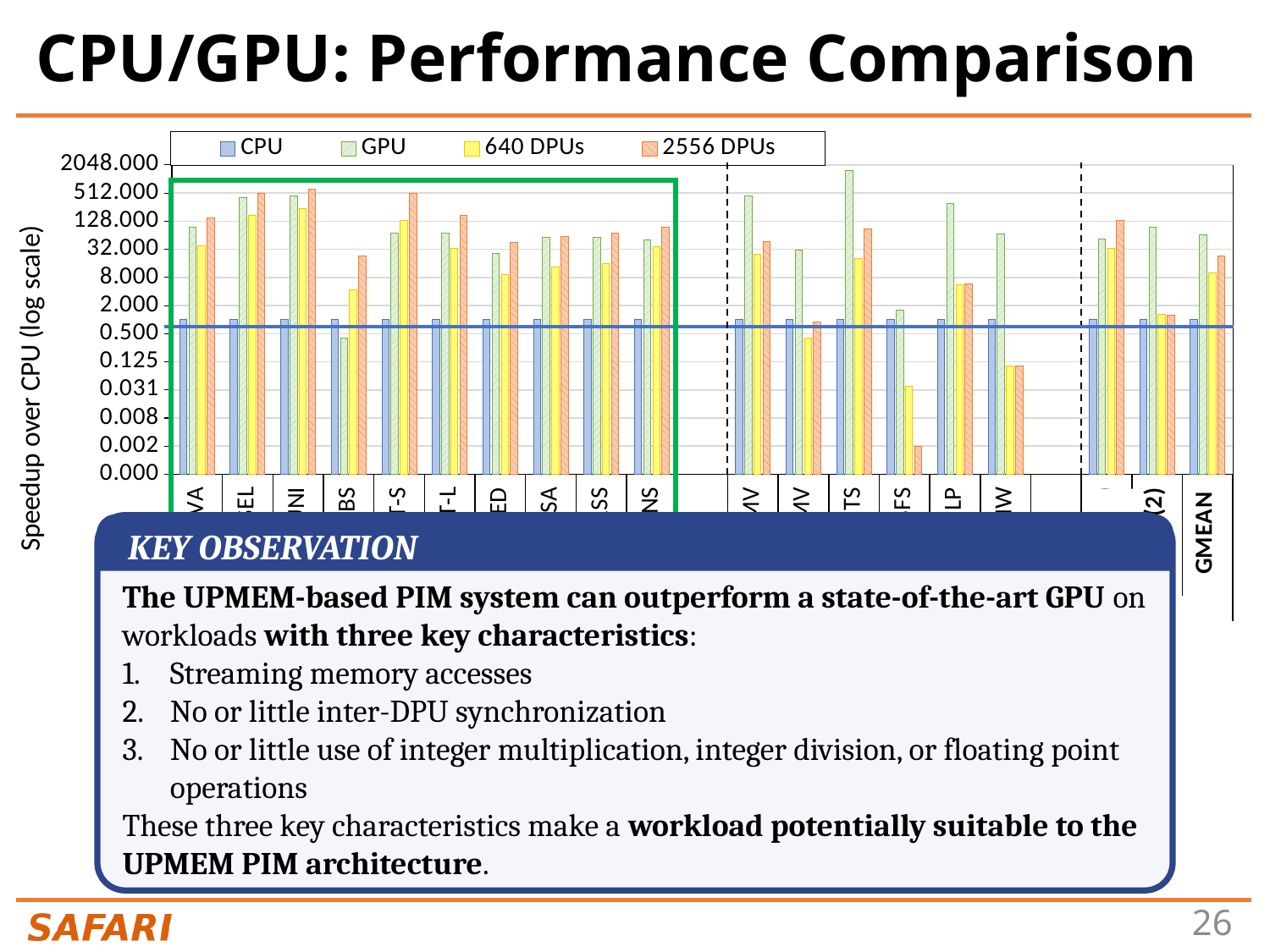
What is the label of the chart's vertical axis? Speedup over CPU (log scale) How many series does the chart's legend list? 4 Is the GPU value for BS greater or less than 0.500? less For TS, which is larger: the GPU value or the 2556 DPUs value? GPU For LP, which is larger: the GPU value or the 640 DPUs value? GPU Is the GPU value for TS greater or less than 512.000? greater For BS, which is larger: the GPU value or the 2556 DPUs value? 2556 DPUs Is the 640 DPUs value for GMEAN greater or less than 32.000? less What kind of chart is shown on the slide? bar chart Which series are listed in the chart's legend? CPU, GPU, 640 DPUs, 2556 DPUs